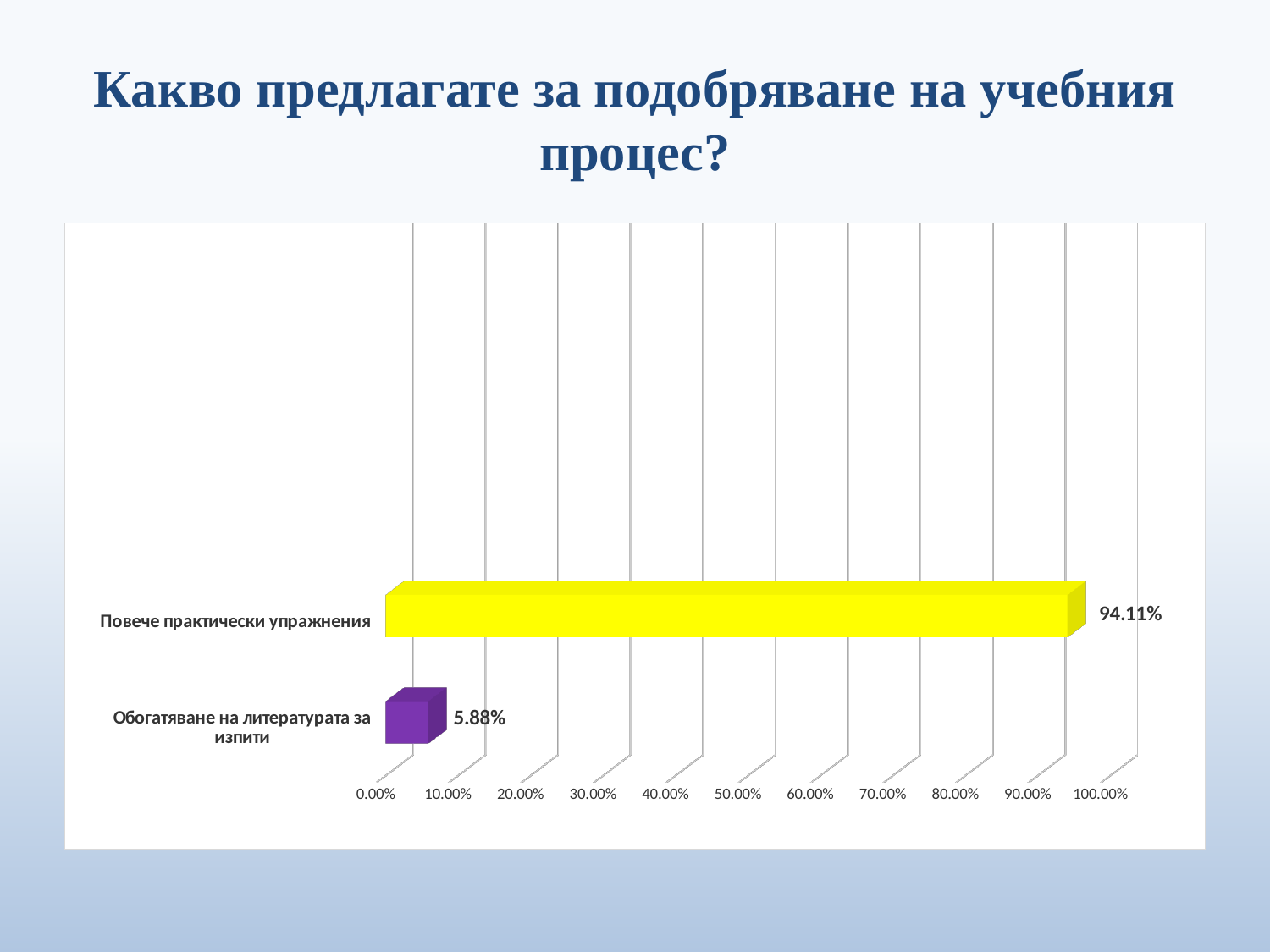
What is the value for "Обогатяване на литературата за изпити"? 5.88% How many categories are shown in the chart? 2 What is the difference between the values for "Повече практически упражнения" and "Обогатяване на литературата за изпити"? 88.23% Which category has the lowest value? Обогатяване на литературата за изпити Which category has the highest value? Повече практически упражнения What colour is the bar for "Повече практически упражнения"? yellow Is the value for "Повече практически упражнения" greater or less than 90.00%? greater What is the value for "Повече практически упражнения"? 94.11% What is the title of the slide? Какво предлагате за подобряване на учебния процес? Is the value for "Обогатяване на литературата за изпити" greater or less than 10.00%? less Which is larger: the value for "Повече практически упражнения" or for "Обогатяване на литературата за изпити"? Повече практически упражнения What kind of chart is shown on the slide? bar chart